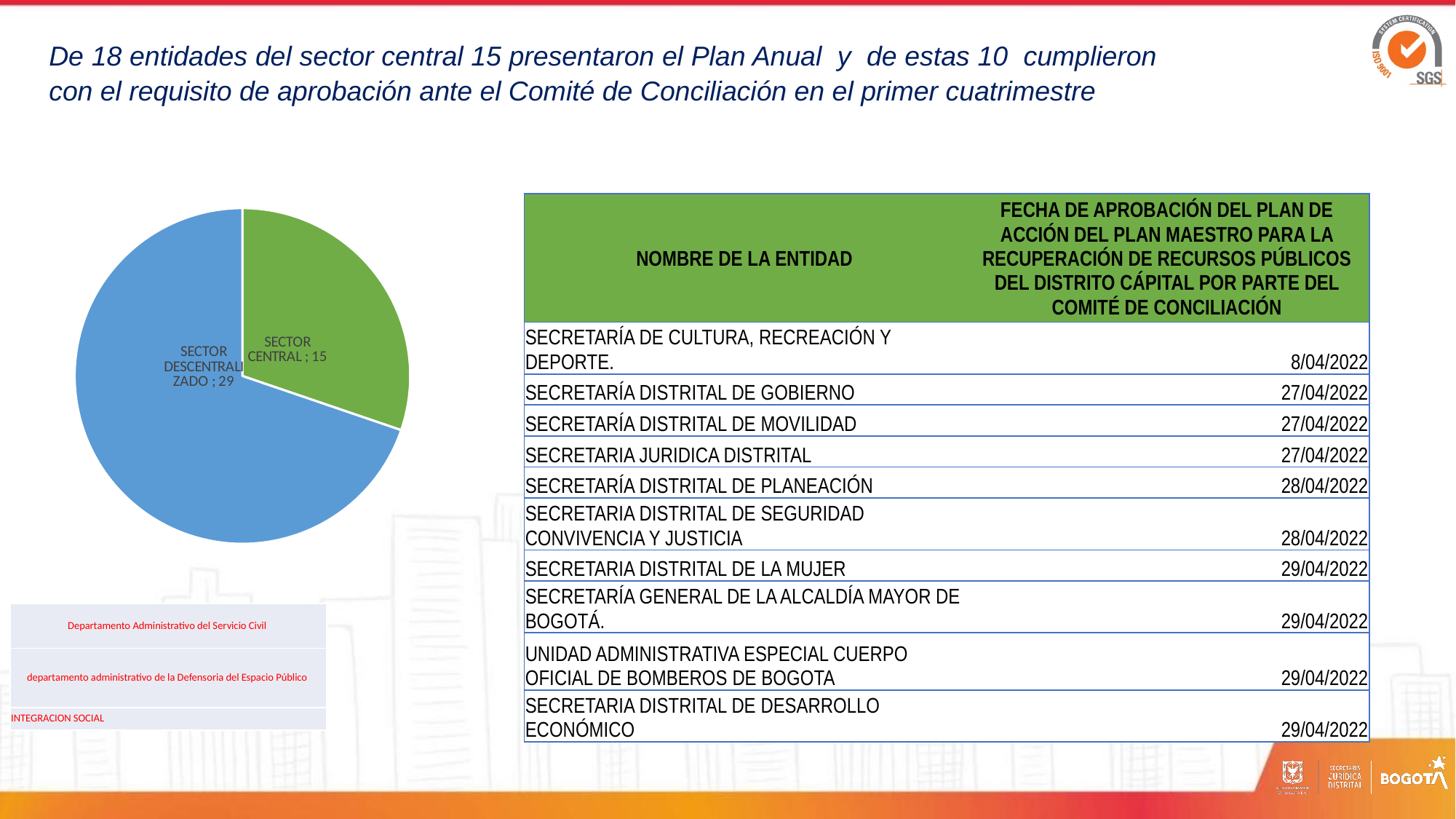
Which is larger in the pie chart, SECTOR CENTRAL or SECTOR DESCENTRALIZADO? SECTOR DESCENTRALIZADO Which slice of the pie chart is the largest? SECTOR DESCENTRALIZADO What is the difference between the SECTOR DESCENTRALIZADO and SECTOR CENTRAL values in the pie chart? 14 What is the value for SECTOR DESCENTRALIZADO in the pie chart? 29 What colour is the SECTOR CENTRAL slice in the pie chart? green What colour is the SECTOR DESCENTRALIZADO slice in the pie chart? blue Which slice of the pie chart is the smallest? SECTOR CENTRAL What is the value for SECTOR CENTRAL in the pie chart? 15 What type of chart is shown on the left of the slide? pie chart How many slices does the pie chart have? 2 What is the total of the two slices in the pie chart? 44